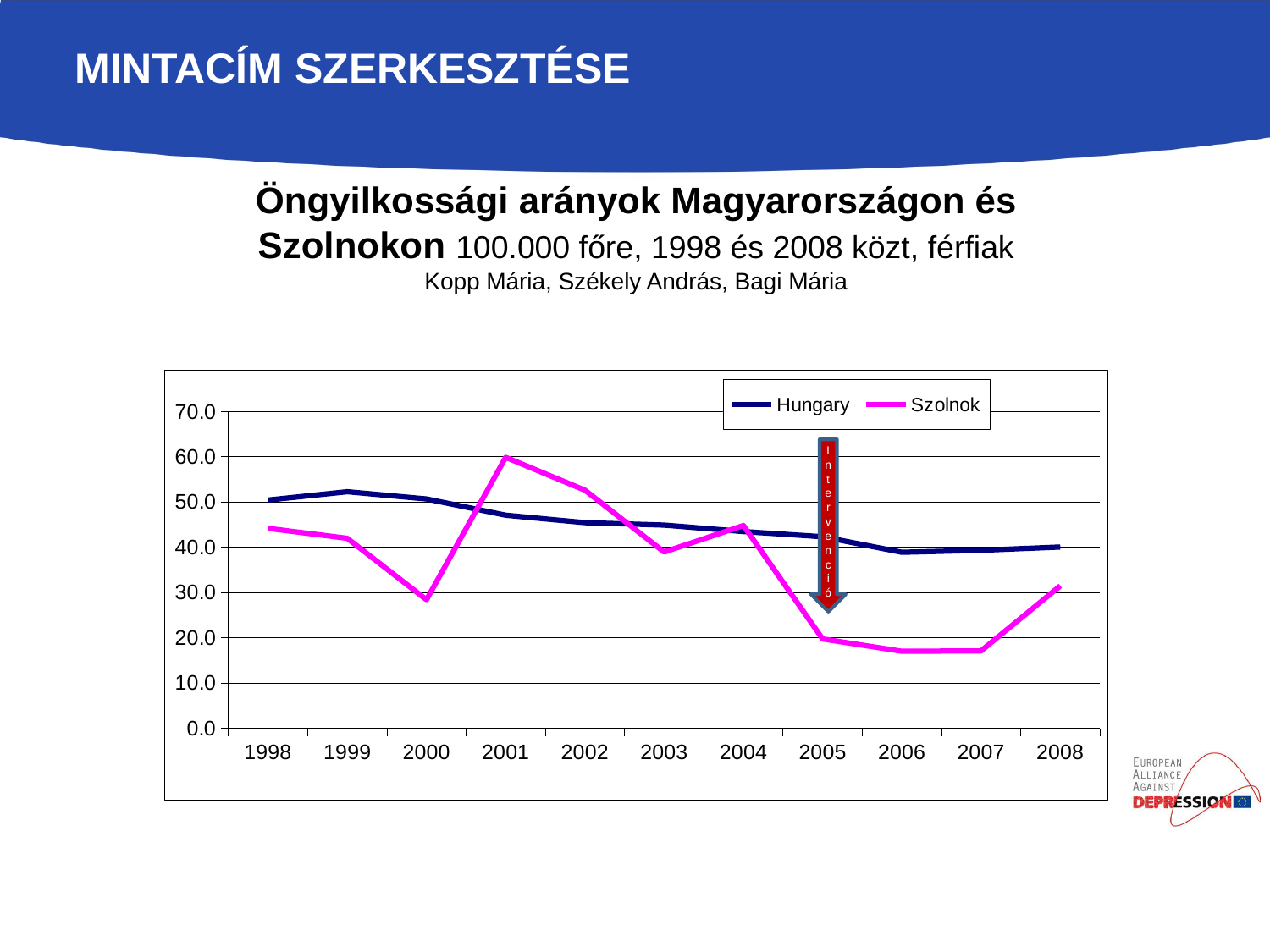
Which colour is used for the Szolnok line in the legend? magenta (pink) How many series does the legend list? 2 Does the Hungary line generally rise or fall from 1998 to 2008? fall Is the value for Szolnok in 2000 greater or less than 40? less Is the value for Hungary in 2008 greater or less than 30? greater In which year does the Szolnok line reach its highest value? 2001 Is the value for Szolnok in 2001 greater or less than 50? greater In 2005, which series has the larger value, Hungary or Szolnok? Hungary How many years are plotted along the x axis? 11 In 2001, which series has the larger value, Hungary or Szolnok? Szolnok What kind of chart is shown on the slide? line chart